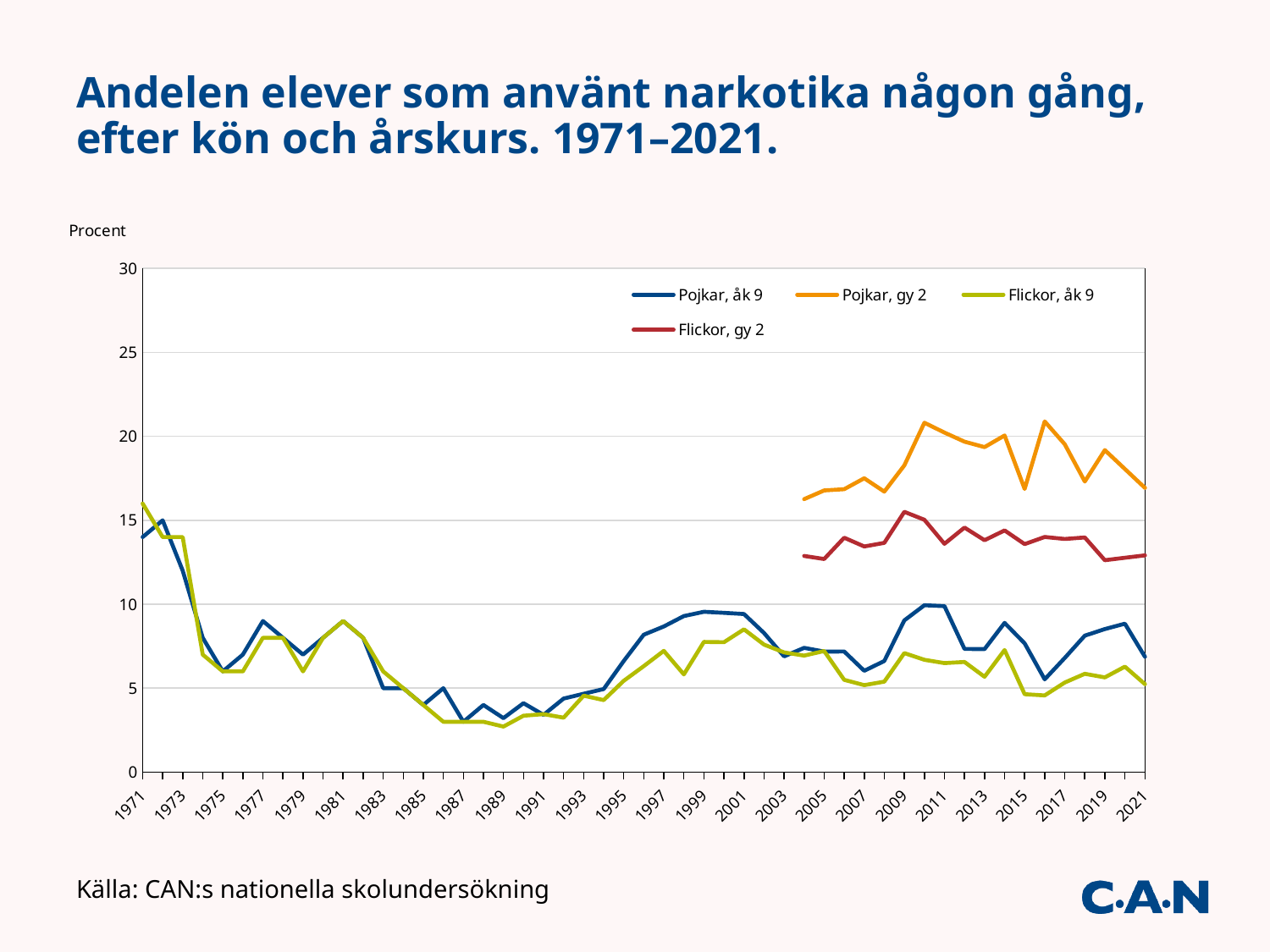
Which series has the highest value in 2021? Pojkar, gy 2 In 2005, which is higher: Pojkar, gy 2 or Flickor, gy 2? Pojkar, gy 2 Is the value for Pojkar, åk 9 in 1987 greater or less than 5? less How many series does the legend list? 4 Does the value for Pojkar, åk 9 rise or fall from 1971 to 1975? fall Is the value for Flickor, gy 2 in 2019 greater or less than 15? less Which series are listed in the legend? Pojkar, åk 9; Pojkar, gy 2; Flickor, åk 9; Flickor, gy 2 In 2021, which is higher: Pojkar, åk 9 or Flickor, åk 9? Pojkar, åk 9 Is the value for Flickor, åk 9 in 2021 greater or less than 10? less What kind of chart is shown on the slide? Line chart What unit is shown on the y axis? Procent